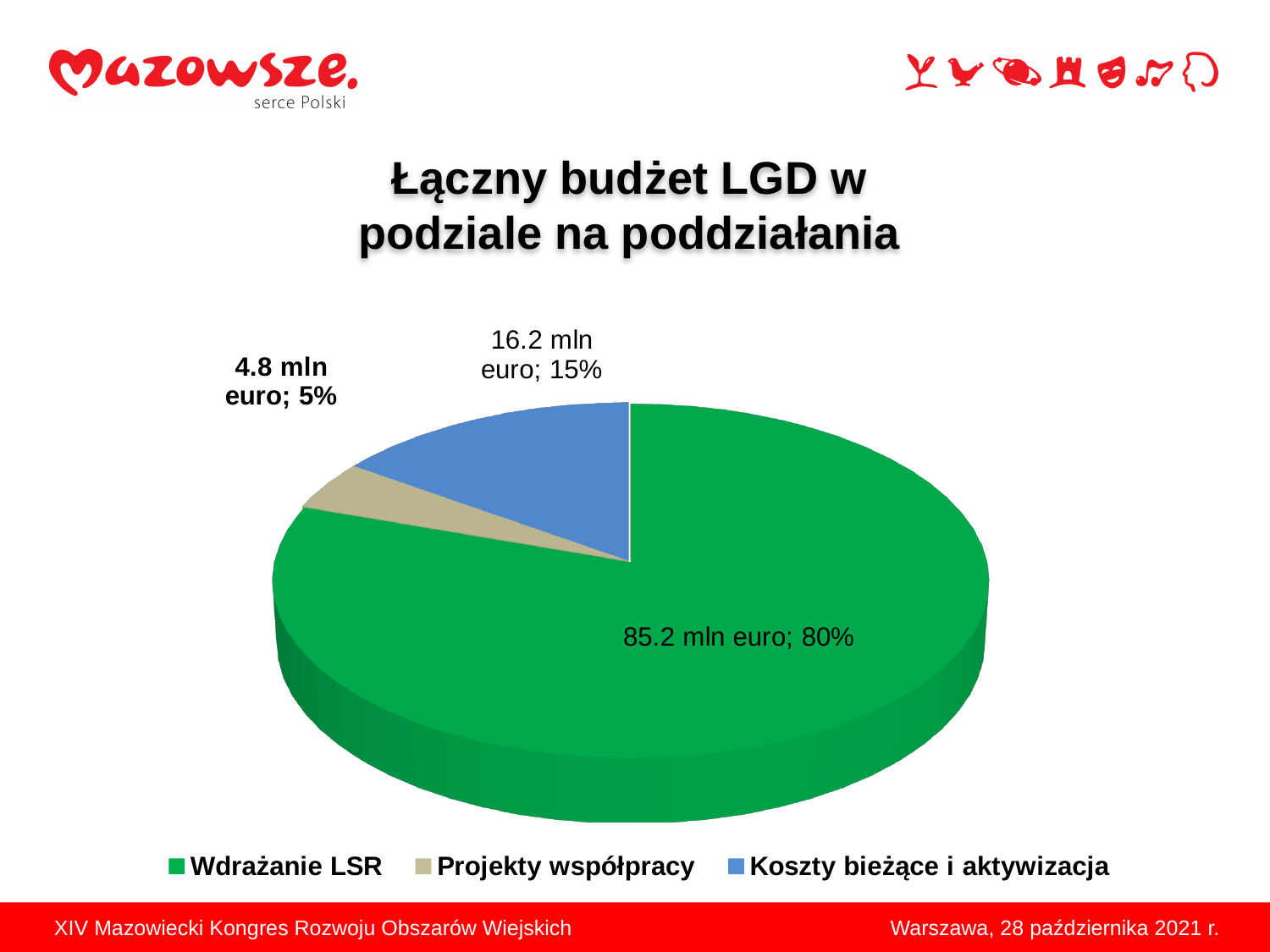
What kind of chart is shown on the slide? Pie chart What is the value shown for Wdrażanie LSR? 85.2 mln euro What is the value shown for Koszty bieżące i aktywizacja? 16.2 mln euro What is the difference in mln euro between Koszty bieżące i aktywizacja and Projekty współpracy? 11.4 mln euro Which category has the largest slice of the pie? Wdrażanie LSR Which category has the smallest slice of the pie? Projekty współpracy How many categories does the pie chart show? 3 What share of the pie does Koszty bieżące i aktywizacja represent? 15% What colour is the slice for Koszty bieżące i aktywizacja? Blue What share of the pie does Wdrażanie LSR represent? 80% What share of the pie does Projekty współpracy represent? 5% What is the value shown for Projekty współpracy? 4.8 mln euro